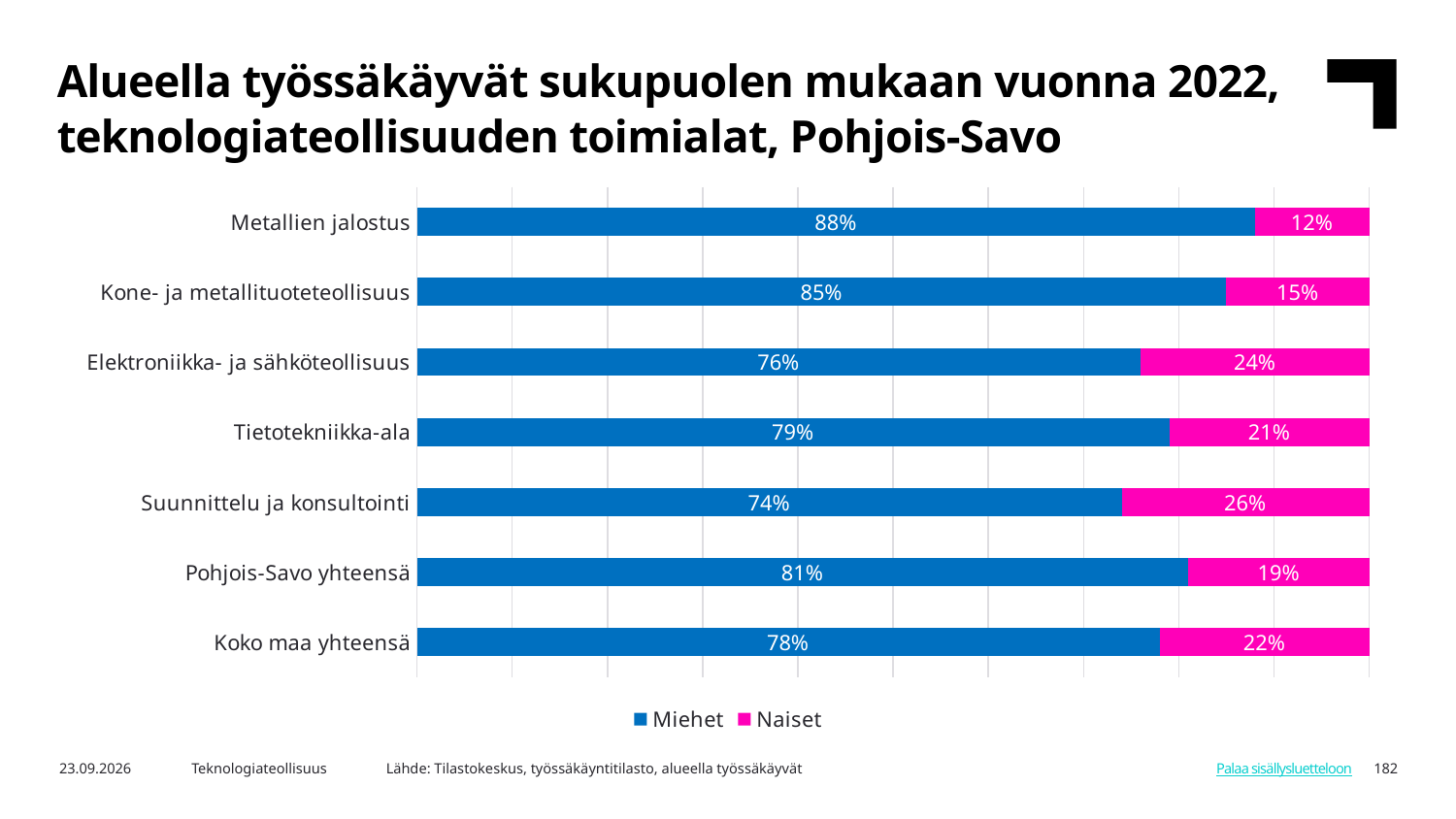
What is the Miehet share for Metallien jalostus? 88% What is the difference between the Miehet share for Metallien jalostus and for Koko maa yhteensä? 10 percentage points What is the total of the stacked bar for Kone- ja metallituoteteollisuus? 100% Which colour represents Naiset in the chart? Pink (magenta) What is the Naiset share for Pohjois-Savo yhteensä? 19% Which category has the lowest Miehet share? Suunnittelu ja konsultointi What kind of chart is shown on the slide? Stacked bar chart How many categories are shown on the chart? 7 How many series does the legend list? 2 Which category has the highest Naiset share? Suunnittelu ja konsultointi What is the Naiset share for Suunnittelu ja konsultointi? 26% Which is larger: the Naiset share for Tietotekniikka-ala or for Elektroniikka- ja sähköteollisuus? Elektroniikka- ja sähköteollisuus